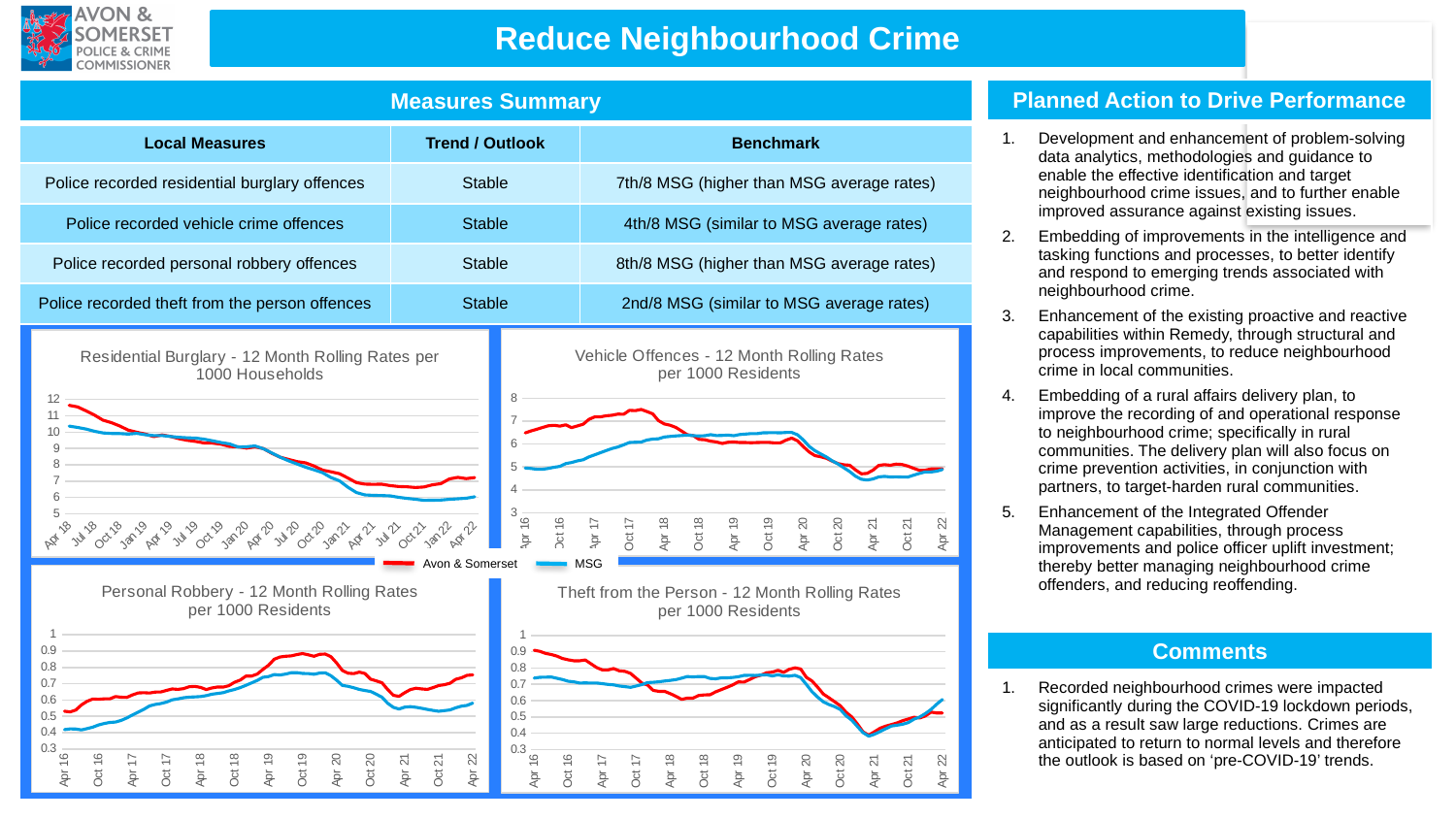
In the 'Theft from the Person - 12 Month Rolling Rates per 1000 Residents' chart, is the Avon & Somerset value at Apr 16 greater or less than 0.8? greater How many series does the shared legend list for the four charts? 2 Which colour represents the MSG series in the legend? Blue What type of chart is the 'Residential Burglary - 12 Month Rolling Rates per 1000 Households' chart? Line chart In the 'Residential Burglary' chart, do the Avon & Somerset values generally rise or fall from Apr 18 to Apr 22? Fall In the 'Personal Robbery - 12 Month Rolling Rates per 1000 Residents' chart, is the MSG value at Apr 16 greater or less than 0.5? less In the 'Residential Burglary' chart, is the MSG value at Apr 22 greater or less than 7? less In the 'Vehicle Offences' chart, which series is higher at Apr 16, Avon & Somerset or MSG? Avon & Somerset In the 'Theft from the Person' chart, which series is higher at Apr 22, Avon & Somerset or MSG? MSG In the 'Personal Robbery' chart, which series is higher at Apr 22, Avon & Somerset or MSG? Avon & Somerset